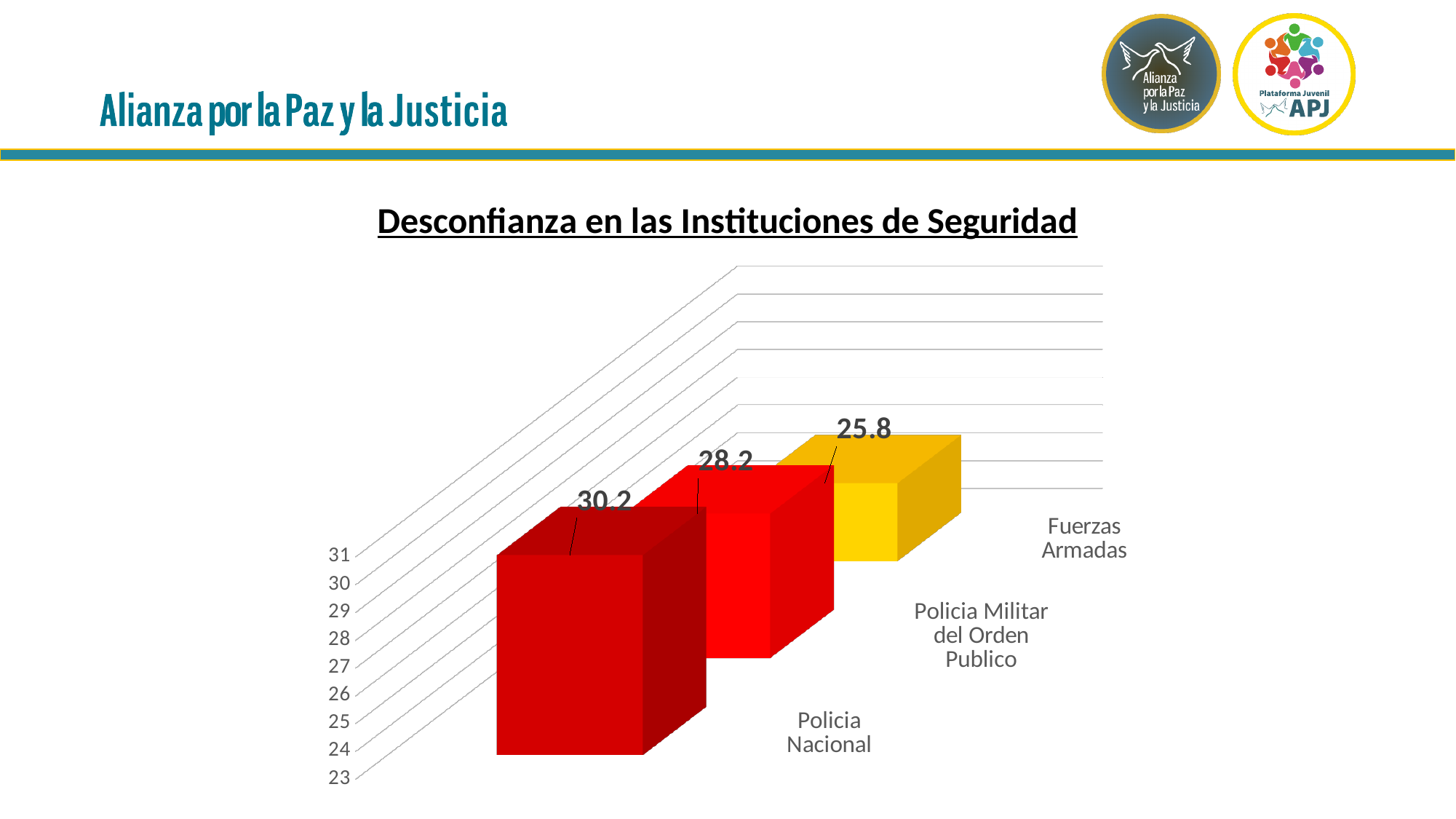
Which category has the highest value? Policia Nacional What is the difference between the values for Policia Nacional and Fuerzas Armadas? 4.4 What kind of chart is shown on the slide? bar chart What is the difference between the values for Policia Nacional and Policia Militar del Orden Publico? 2 Which is larger, the value for Policia Militar del Orden Publico or the value for Fuerzas Armadas? Policia Militar del Orden Publico What is the value for Policia Militar del Orden Publico? 28.2 What is the value for Policia Nacional? 30.2 Is the value for Fuerzas Armadas greater or less than 27? less What is the title of the chart? Desconfianza en las Instituciones de Seguridad Which category has the lowest value? Fuerzas Armadas What is the value for Fuerzas Armadas? 25.8 How many categories are shown in the chart? 3